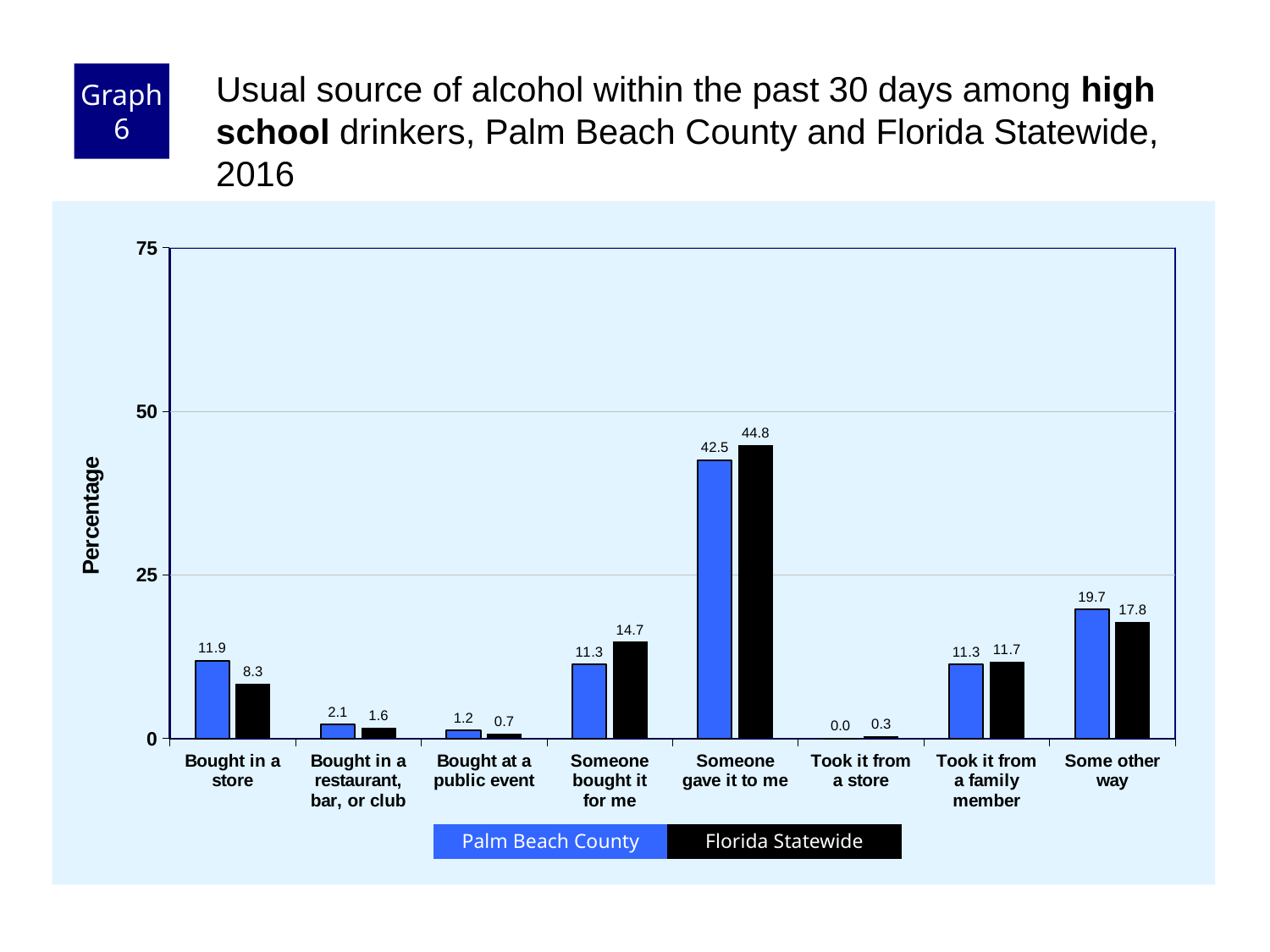
What is the difference between the Florida Statewide and Palm Beach County values for "Someone bought it for me"? 3.4 What is the label of the y axis? Percentage What is the Florida Statewide value for "Bought in a store"? 8.3 For "Some other way", which is larger: Palm Beach County or Florida Statewide? Palm Beach County What is the Florida Statewide value for "Took it from a store"? 0.3 Which category has the lowest Palm Beach County value? Took it from a store What is the Palm Beach County value for "Someone gave it to me"? 42.5 How many series does the legend list? 2 Is the Florida Statewide value for "Someone gave it to me" greater or less than 50? less How many categories are shown on the x axis? 8 What kind of chart is shown on the slide? bar chart Which category has the highest Florida Statewide value? Someone gave it to me